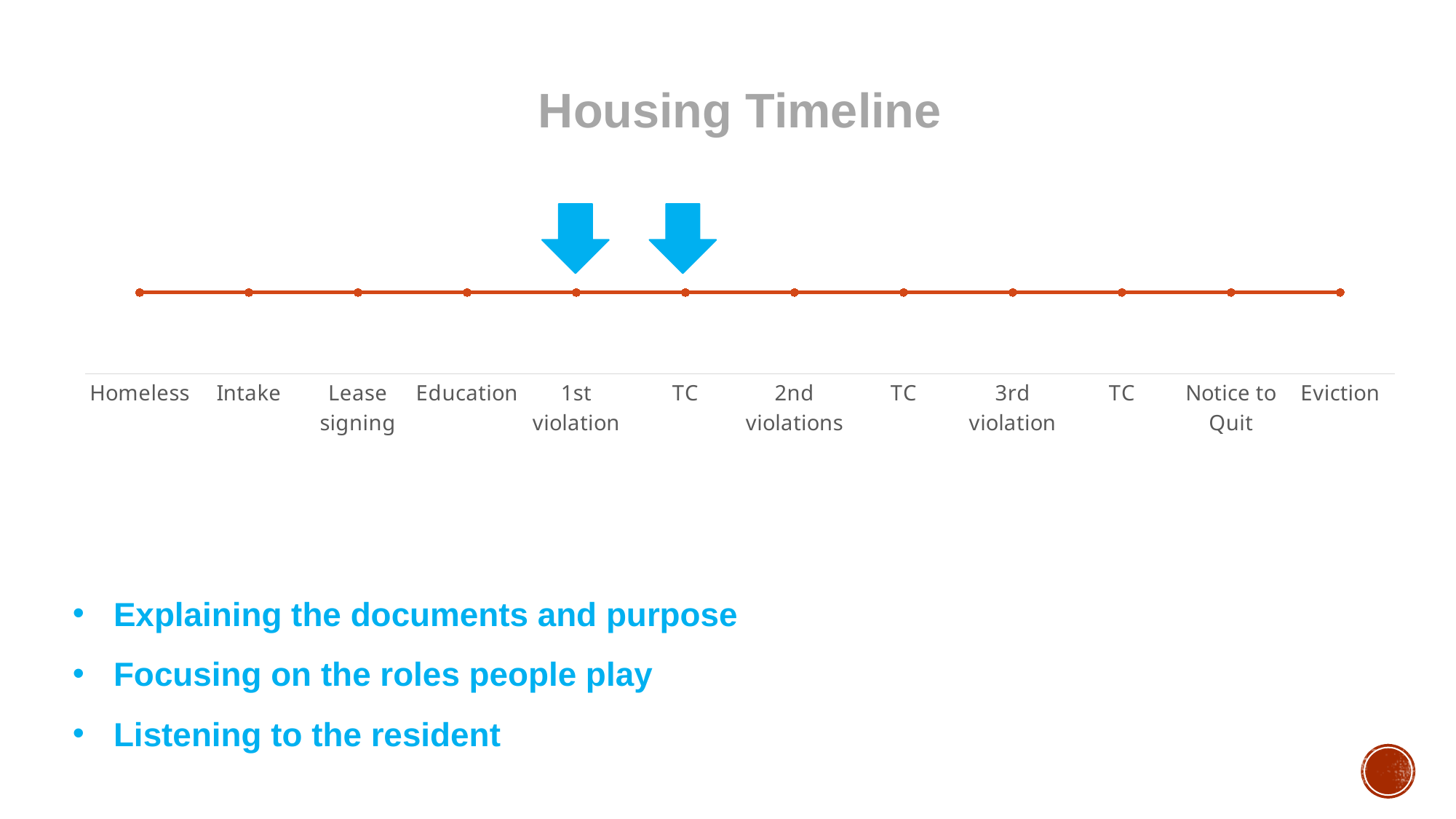
How many data points are plotted on the line? 12 Which category comes immediately after "Lease signing" on the x axis? Education Which two categories do the blue arrows above the line point to? 1st violation and TC Do the plotted values rise, fall, or stay flat along the x axis? flat Which category comes immediately before "Eviction" on the x axis? Notice to Quit How many times does the category label "TC" appear on the x axis? 3 How many categories are labelled along the x axis of the chart? 12 What kind of chart is shown on the slide? line chart